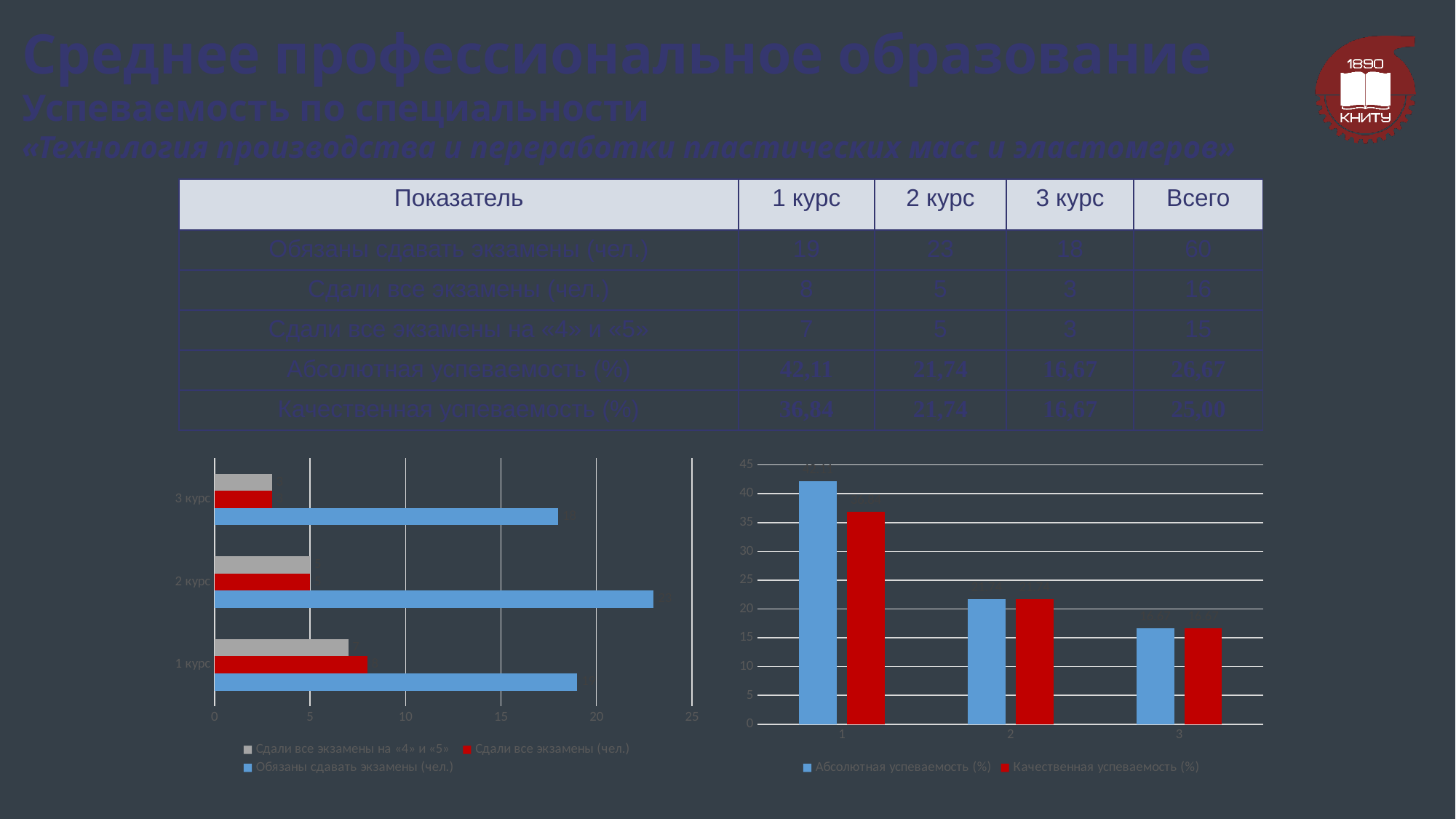
On the left chart, is the value of «Обязаны сдавать экзамены (чел.)» for 2 курс greater or less than 20? greater On the left chart, what is the value of «Сдали все экзамены (чел.)» for 2 курс? 5 On the right chart, is the value of «Абсолютная успеваемость (%)» for category 1 greater or less than 40? greater How many series does the legend of the left chart list? 3 What kind of chart is the chart on the left of the slide? bar chart On the left chart, which course has the highest value for «Обязаны сдавать экзамены (чел.)»? 2 курс How many series does the legend of the right chart list? 2 On the left chart, is the value of «Сдали все экзамены на «4» и «5»» for 1 курс greater or less than 5? greater What kind of chart is the chart on the right of the slide? bar chart How many categories (courses) are shown on the left chart? 3 On the right chart, does «Абсолютная успеваемость (%)» rise or fall from category 1 to category 3? fall On the right chart, for category 1, which is larger: «Абсолютная успеваемость (%)» or «Качественная успеваемость (%)»? Абсолютная успеваемость (%)